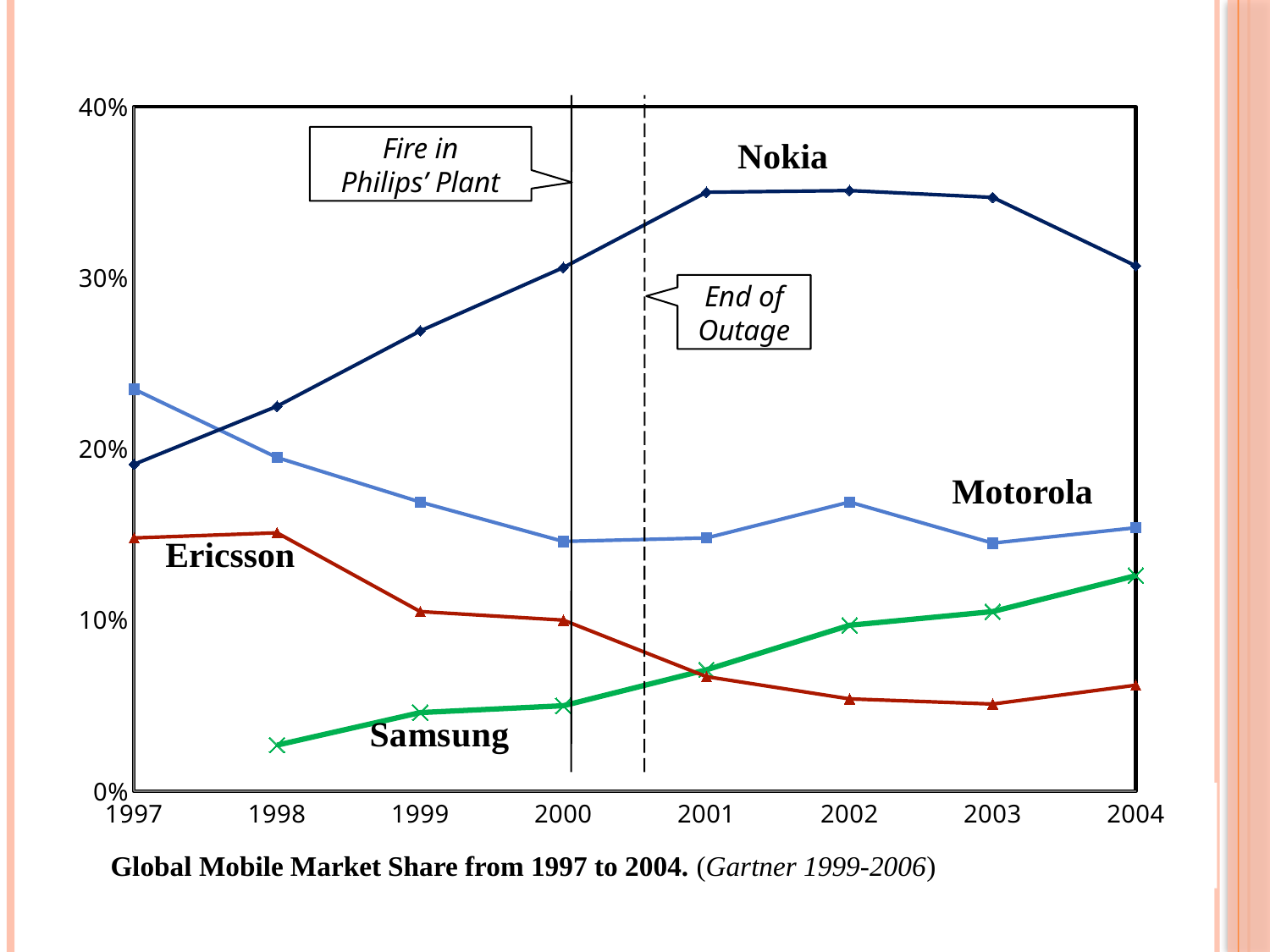
Is Ericsson's market share in 2003 greater or less than 10%? less How many companies' market share lines are plotted on the chart? 4 What event does the annotation at the solid vertical line in 2000 describe? Fire in Philips' Plant How many years are shown along the x axis of the chart? 8 Is Motorola's market share in 1997 greater or less than 20%? greater What kind of chart is shown on the slide? Line chart Does Ericsson's market share rise or fall from 1998 to 2003? Fall Which company has the highest market share in 2004? Nokia Is Nokia's market share in 2002 greater or less than 30%? greater Which company has the lowest market share in 2004? Ericsson Which company has the highest market share in 1997? Motorola In 2004, which has the larger market share, Samsung or Ericsson? Samsung